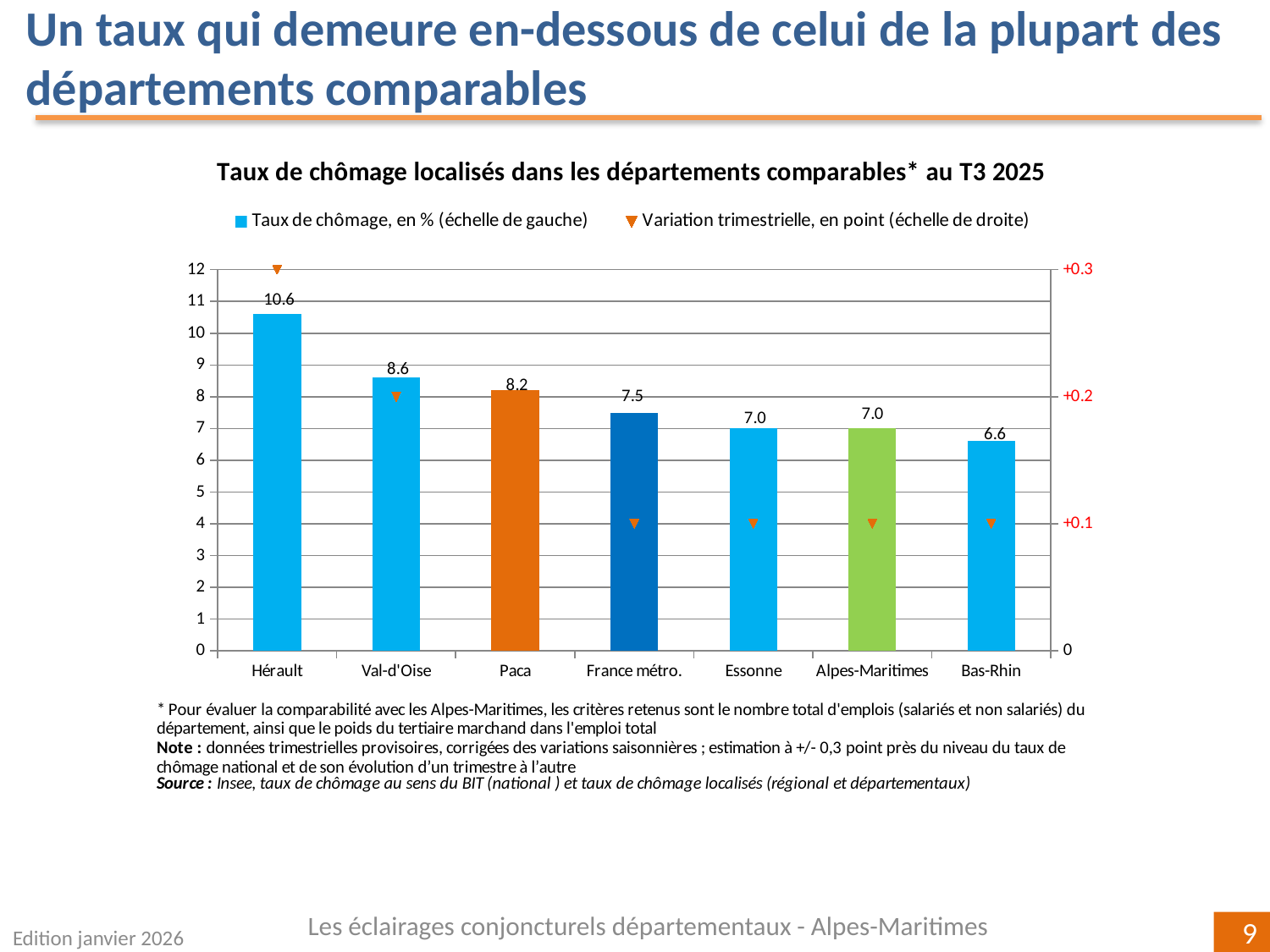
What is the unemployment rate shown for France métro.? 7.5 How many series does the legend list? 2 What kind of chart is this? Bar chart Which category has the highest unemployment rate? Hérault What is the difference between the unemployment rates of Hérault and Bas-Rhin? 4.0 What is the quarterly variation (Variation trimestrielle) shown for Hérault on the right axis? +0.3 What is the unemployment rate (Taux de chômage) shown for Hérault? 10.6 Which has a higher unemployment rate, Val-d'Oise or Paca? Val-d'Oise How many categories are shown on the x axis? 7 Which category has the lowest unemployment rate? Bas-Rhin What is the unemployment rate shown for Alpes-Maritimes? 7.0 What is the quarterly variation shown for Val-d'Oise on the right axis? +0.2